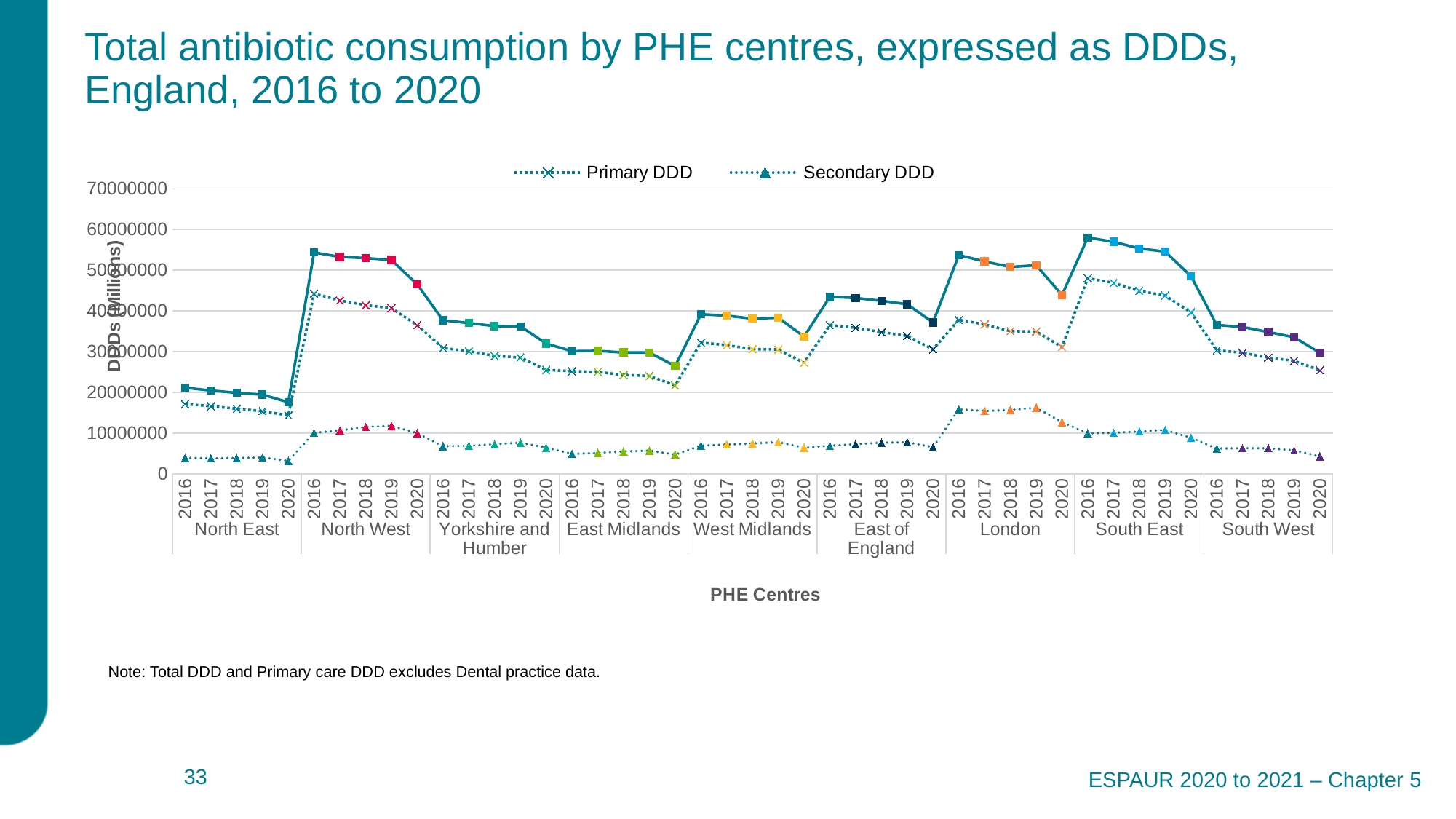
Is the Primary DDD value for East Midlands in 2020 greater or less than 30000000? less Which is larger, the Primary DDD value for South East in 2016 or for North East in 2016? South East in 2016 Is the Secondary DDD value for London in 2019 greater or less than 10000000? greater Is the Secondary DDD value for North East in 2016 greater or less than 10000000? less Does the Primary DDD value for North East rise or fall from 2016 to 2020? fall Which PHE centre has the lowest Primary DDD value in 2016? North East How many series does the chart legend list? 2 What kind of chart is shown on the slide? line chart Which PHE centre has the highest Primary DDD value in 2016? South East What is the title of the x axis? PHE Centres How many PHE centres are shown along the x axis? 9